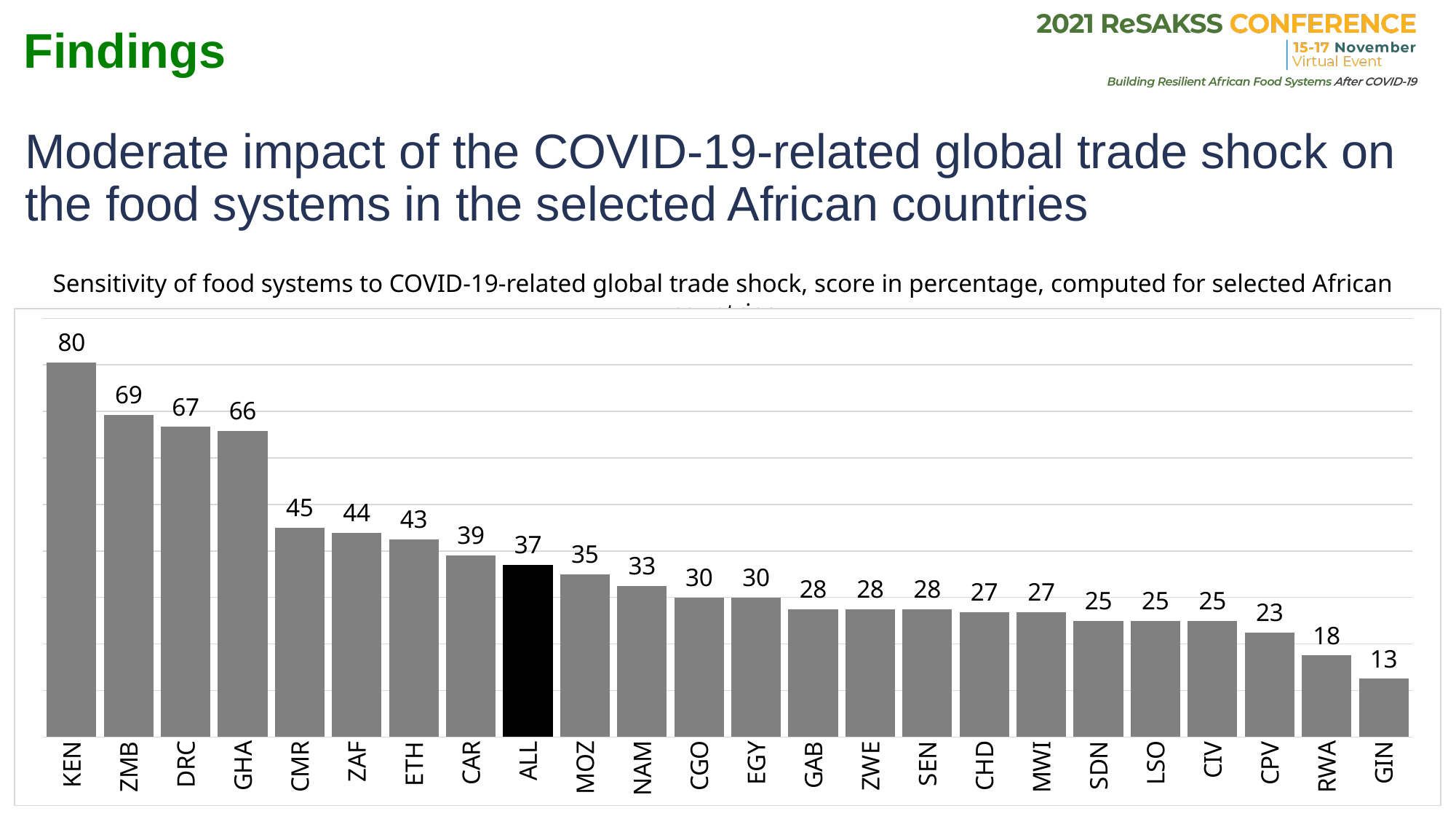
What is the difference between the scores for KEN and GIN? 67 What is the sensitivity score for ALL? 37 Which has a higher score, GHA or CAR? GHA What is the sensitivity score for EGY? 30 What is the sensitivity score for KEN? 80 How many bars are shown in the chart? 24 Which country has the highest sensitivity score? KEN Which bar is coloured black rather than grey? ALL What is the difference between the scores for ZMB and CMR? 24 Which has a higher score, RWA or CPV? CPV Which country has the lowest sensitivity score? GIN What type of chart is shown on the slide? Bar chart